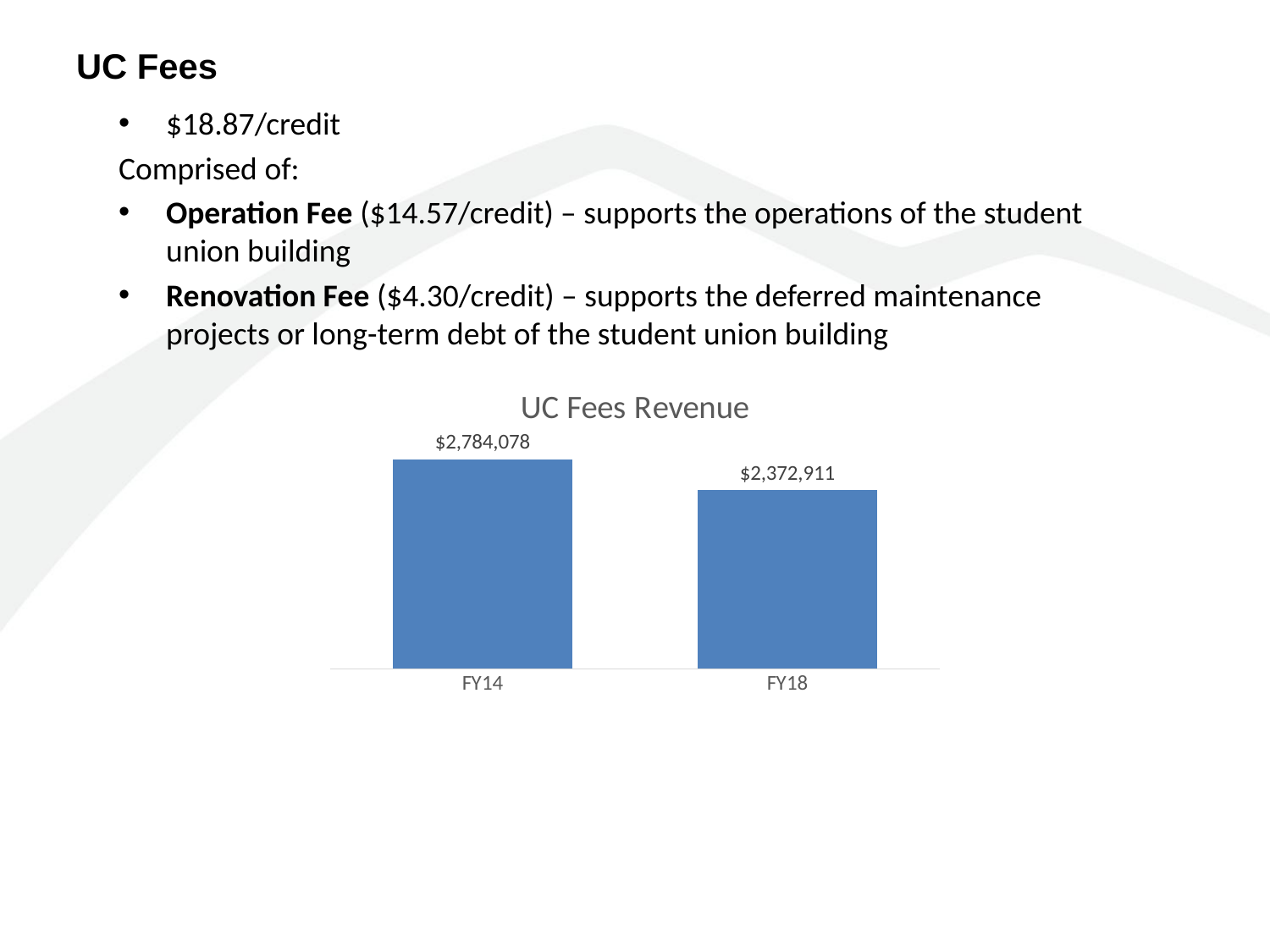
Does UC Fees Revenue rise or fall from FY14 to FY18? Fall What type of chart is used to show UC Fees Revenue? Bar chart What is the title of the chart on the slide? UC Fees Revenue Which fiscal year has the higher UC Fees Revenue? FY14 How many fiscal years are shown in the UC Fees Revenue chart? 2 What is the UC Fees Revenue for FY14? $2,784,078 What is the difference between the FY14 and FY18 UC Fees Revenue? $411,167 What colour are the bars in the UC Fees Revenue chart? Blue What is the UC Fees Revenue for FY18? $2,372,911 Which fiscal year has the lower UC Fees Revenue? FY18 Is the UC Fees Revenue larger in FY14 or FY18? FY14